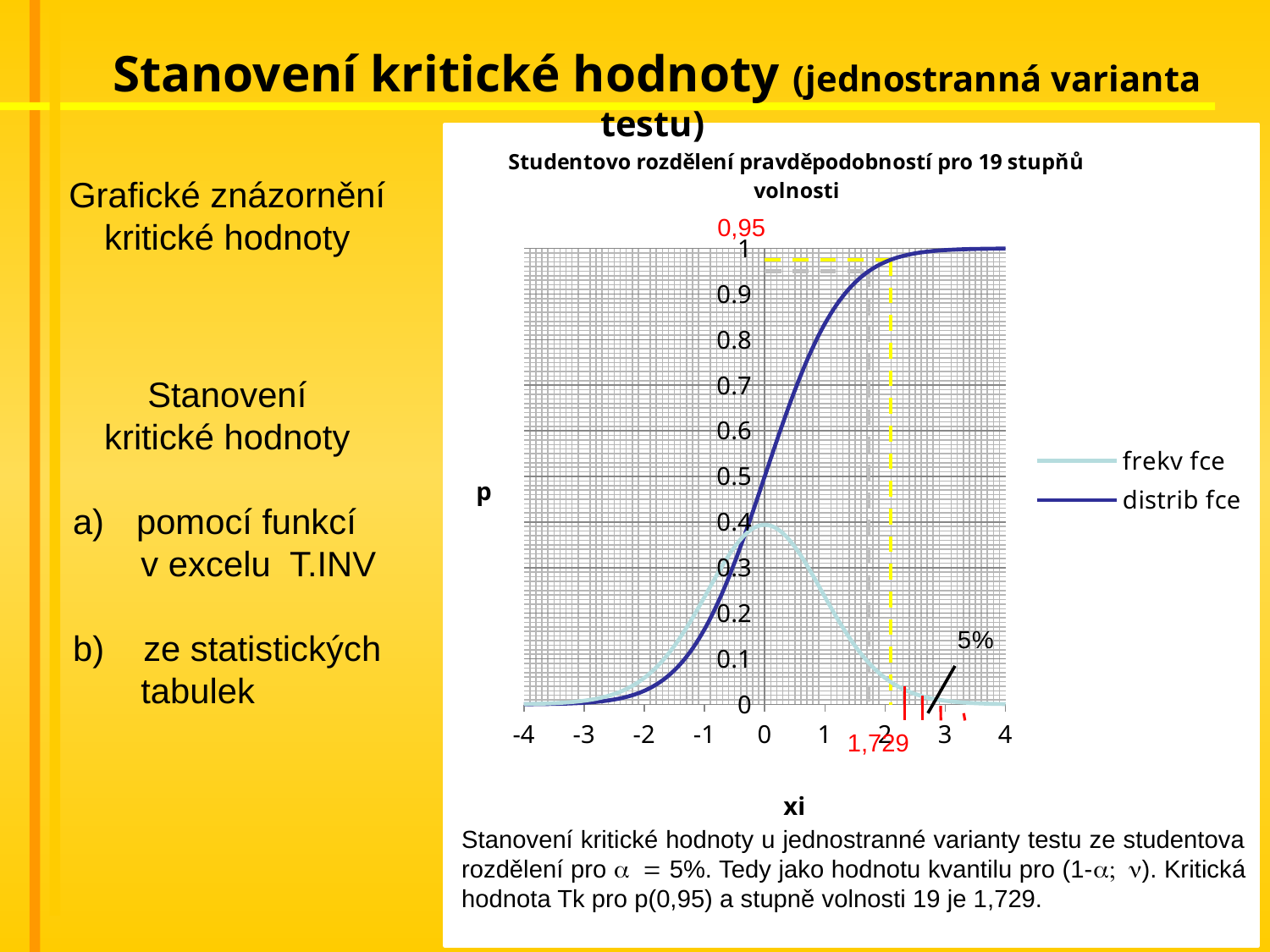
What is the title of the chart? Studentovo rozdělení pravděpodobností pro 19 stupňů volnosti What probability value is marked in red at the top of the y axis of the chart? 0,95 What kind of chart is shown on the slide? line chart Is the value of frekv fce at xi = 0 greater or less than 0.3? greater What critical value is marked in red on the x axis of the chart? 1,729 At xi = 1, which series has the higher value, frekv fce or distrib fce? distrib fce Is the value of distrib fce at xi = -2 greater or less than 0.1? less What are the two series named in the chart legend? frekv fce, distrib fce Does the distrib fce series rise or fall as xi increases from -4 to 4? rise Is the value of distrib fce at xi = 2 greater or less than 0.9? greater How many tick labels are shown on the x axis of the chart? 9 How many series does the chart legend list? 2